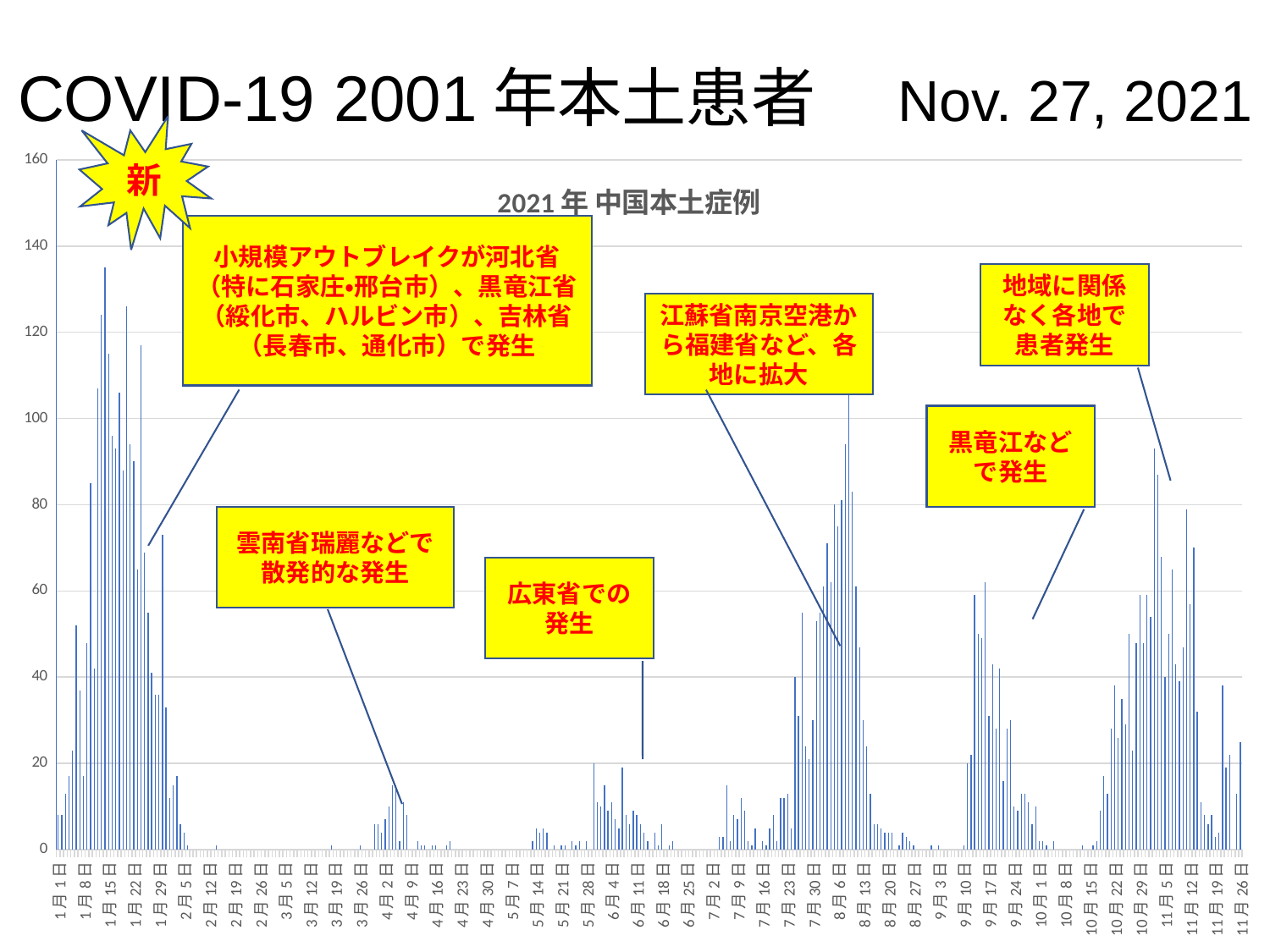
What is the highest value shown on the chart's vertical axis? 160 Which period has the highest bar on the chart: mid-January or early August? mid-January What kind of chart is shown on the slide? bar chart Is the tallest bar in early August (around 8月6日) greater or less than 80? greater Is the tallest bar in early April (around 4月2日) greater or less than 20? less Is the tallest bar in early June (around 6月4日) greater or less than 40? less Which period has the higher peak: early November or mid-September? early November In which month does the chart's overall highest bar occur? 1月 (January) What is the title of the chart? 2021 年 中国本土症例 Do the daily values rise or fall from mid-January to mid-February? fall